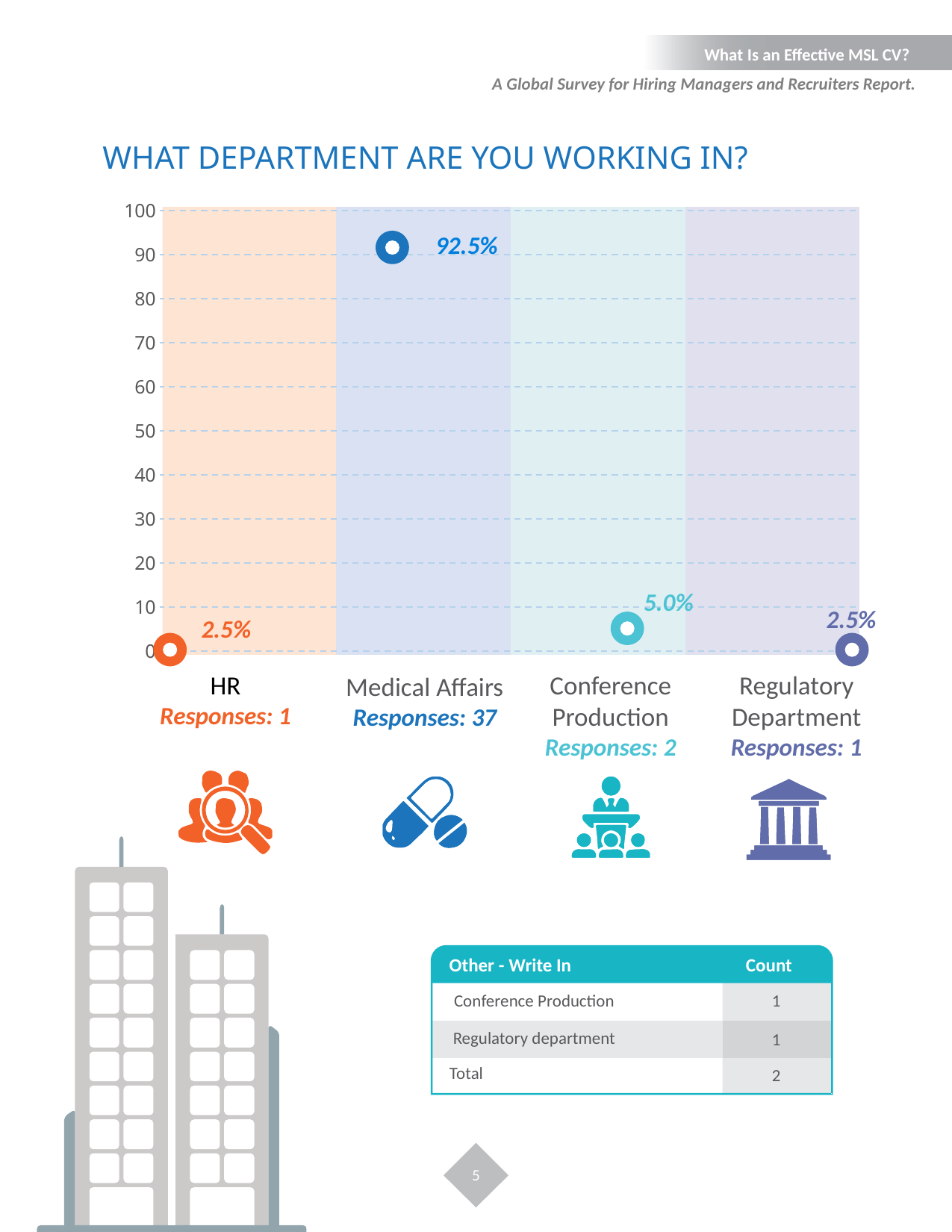
What percentage is shown for HR? 2.5% How many responses are listed for Conference Production? 2 Which department has the highest percentage? Medical Affairs What is the highest value shown on the vertical axis? 100 How many responses are listed for Medical Affairs? 37 What percentage is shown for Medical Affairs? 92.5% How many departments are plotted on the chart? 4 What is the title of the chart? WHAT DEPARTMENT ARE YOU WORKING IN? What is the difference in percentage points between Medical Affairs and Conference Production? 87.5 Which is larger, the percentage for Conference Production or for Regulatory Department? Conference Production Is the value for Medical Affairs greater or less than 90? greater What percentage is shown for Conference Production? 5.0%